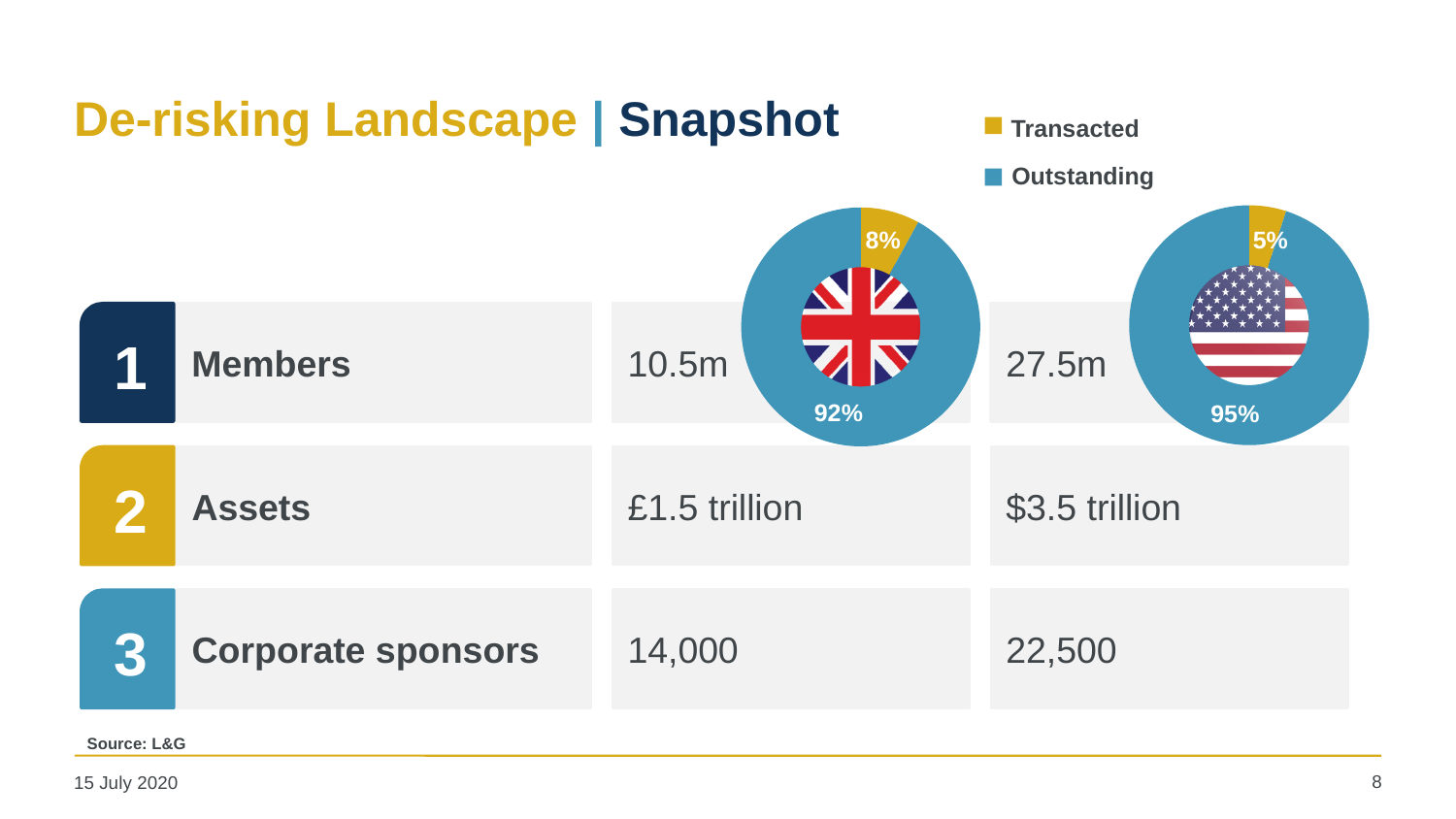
In the right donut chart (with the US flag), which segment is the smallest? Transacted In the right donut chart (with the US flag), what percentage is Outstanding? 95% In the left donut chart (with the UK flag), what percentage is Transacted? 8% What is the difference between the Transacted share in the left (UK flag) chart and the Transacted share in the right (US flag) chart? 3 percentage points In the left donut chart (with the UK flag), what percentage is Outstanding? 92% What type of chart is used to show the Transacted and Outstanding shares? Donut (pie) chart Which colour represents Transacted in the legend? Gold/yellow In the right donut chart (with the US flag), what percentage is Transacted? 5% How many series does the legend list for the donut charts? 2 In the left donut chart (with the UK flag), which segment is the largest? Outstanding What is the difference between the Outstanding and Transacted shares in the left donut chart (with the UK flag)? 84 percentage points Which chart has the larger Transacted share, the left (UK flag) chart or the right (US flag) chart? The left (UK flag) chart